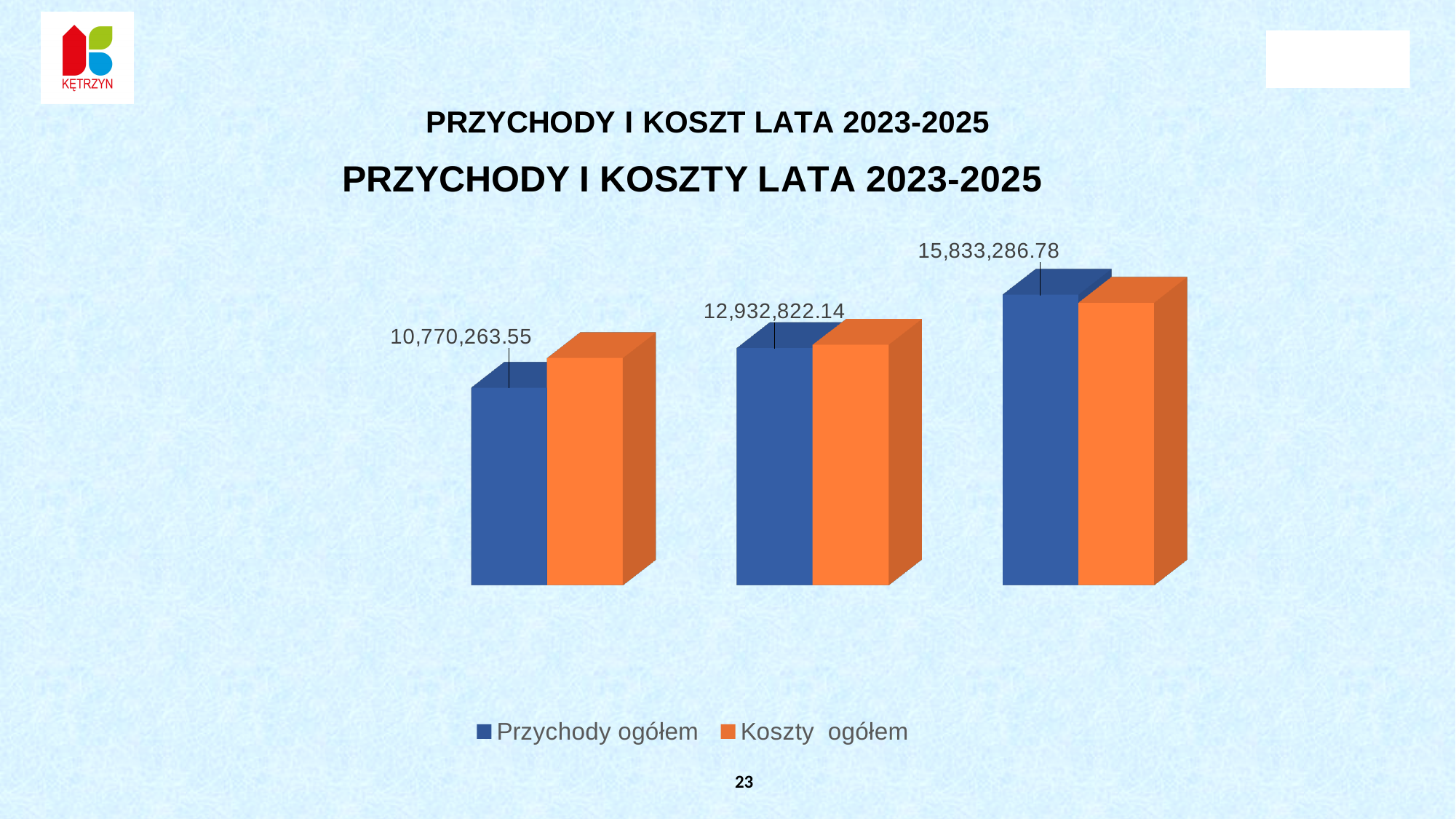
What is the difference between the Przychody ogółem values of the middle and leftmost groups? 2,162,558.59 Do the Przychody ogółem values rise or fall from left to right across the chart? rise What is the Przychody ogółem value labelled on the rightmost group of bars? 15,833,286.78 Which group of bars has the highest Przychody ogółem value? the rightmost group How many groups of bars are plotted in the chart? 3 What is the difference between the Przychody ogółem values of the rightmost and leftmost groups? 5,063,023.23 What is the Przychody ogółem value labelled on the leftmost group of bars? 10,770,263.55 How many series does the legend list? 2 Which group of bars has the lowest Przychody ogółem value? the leftmost group Which series is shown in orange in the legend? Koszty ogółem What is the Przychody ogółem value labelled on the middle group of bars? 12,932,822.14 What kind of chart is shown on the slide? bar chart